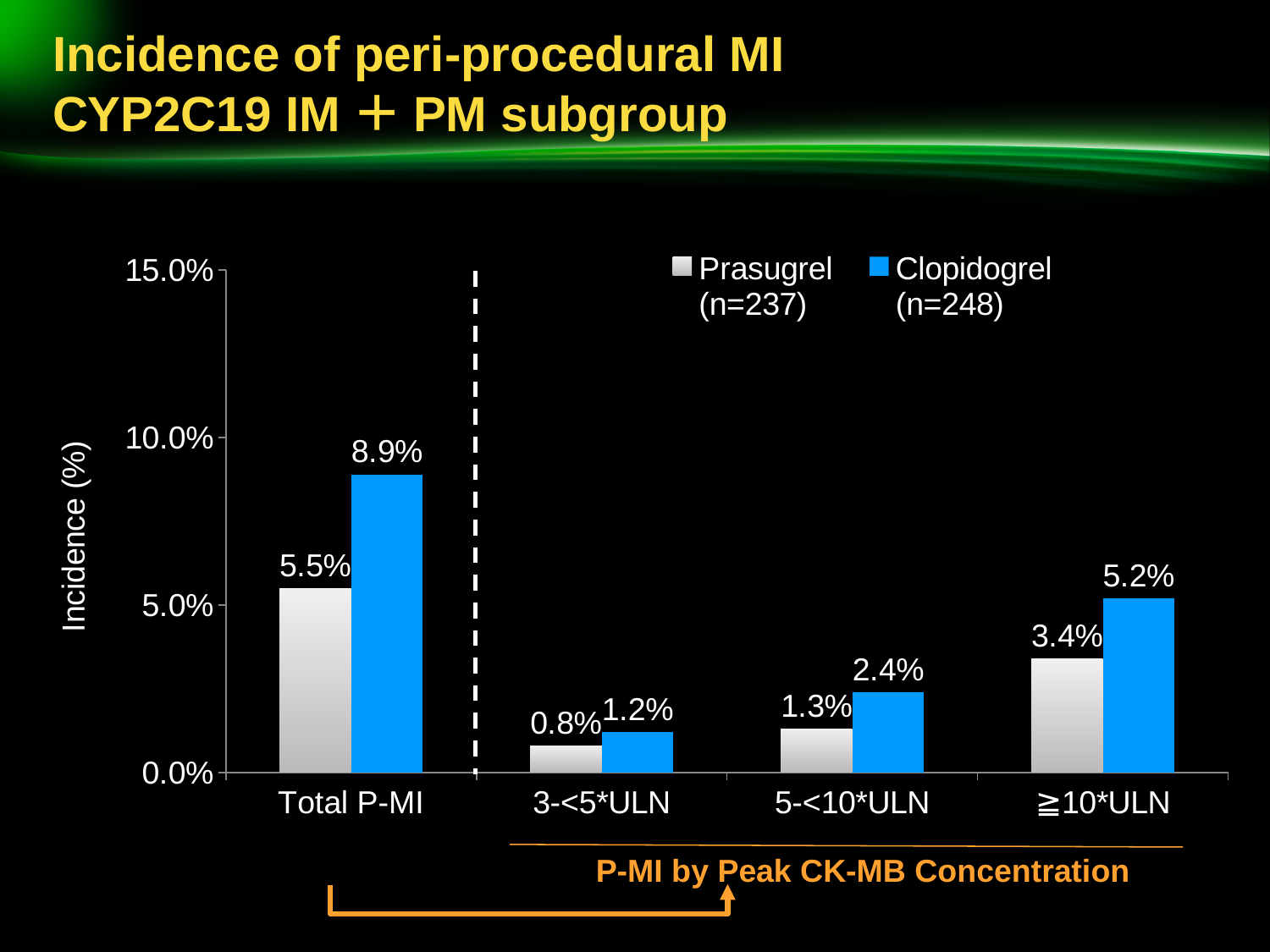
What is the incidence of Total P-MI for Prasugrel? 5.5% How many categories are shown on the x axis? 4 What is the Clopidogrel value for the ≧10*ULN category? 5.2% What is the difference between the Clopidogrel and Prasugrel values for ≧10*ULN? 1.8% What is the incidence of Total P-MI for Clopidogrel? 8.9% What is the Prasugrel value for the 5-<10*ULN category? 1.3% Which category has the highest Clopidogrel incidence? Total P-MI How many series does the legend list? 2 For the 5-<10*ULN category, which treatment has the higher incidence, Prasugrel or Clopidogrel? Clopidogrel What is the difference between the Clopidogrel and Prasugrel values for Total P-MI? 3.4% What type of chart is shown on the slide? Bar chart Which category has the lowest Prasugrel incidence? 3-<5*ULN